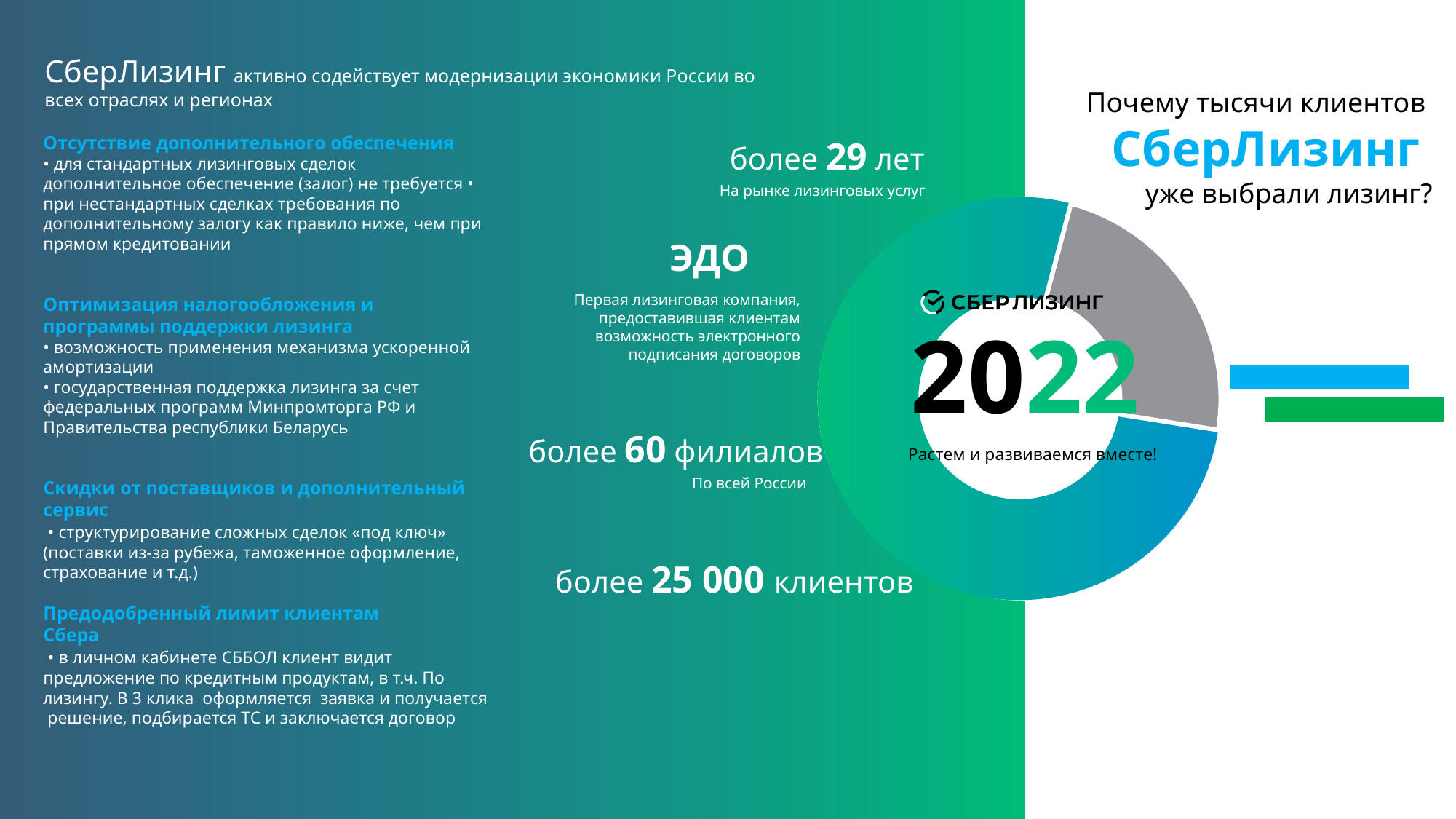
How many slices does the donut chart on the right contain? 3 Which slice of the donut chart is the largest: the teal-green one, the grey one, or the blue one? the teal-green one What kind of chart is shown on the right side of the slide? pie chart (donut) What slogan is printed below the year inside the donut chart? Растем и развиваемся вместе! Is the teal-green slice of the donut chart larger or smaller than the grey slice? larger What year is printed in the centre of the donut chart? 2022